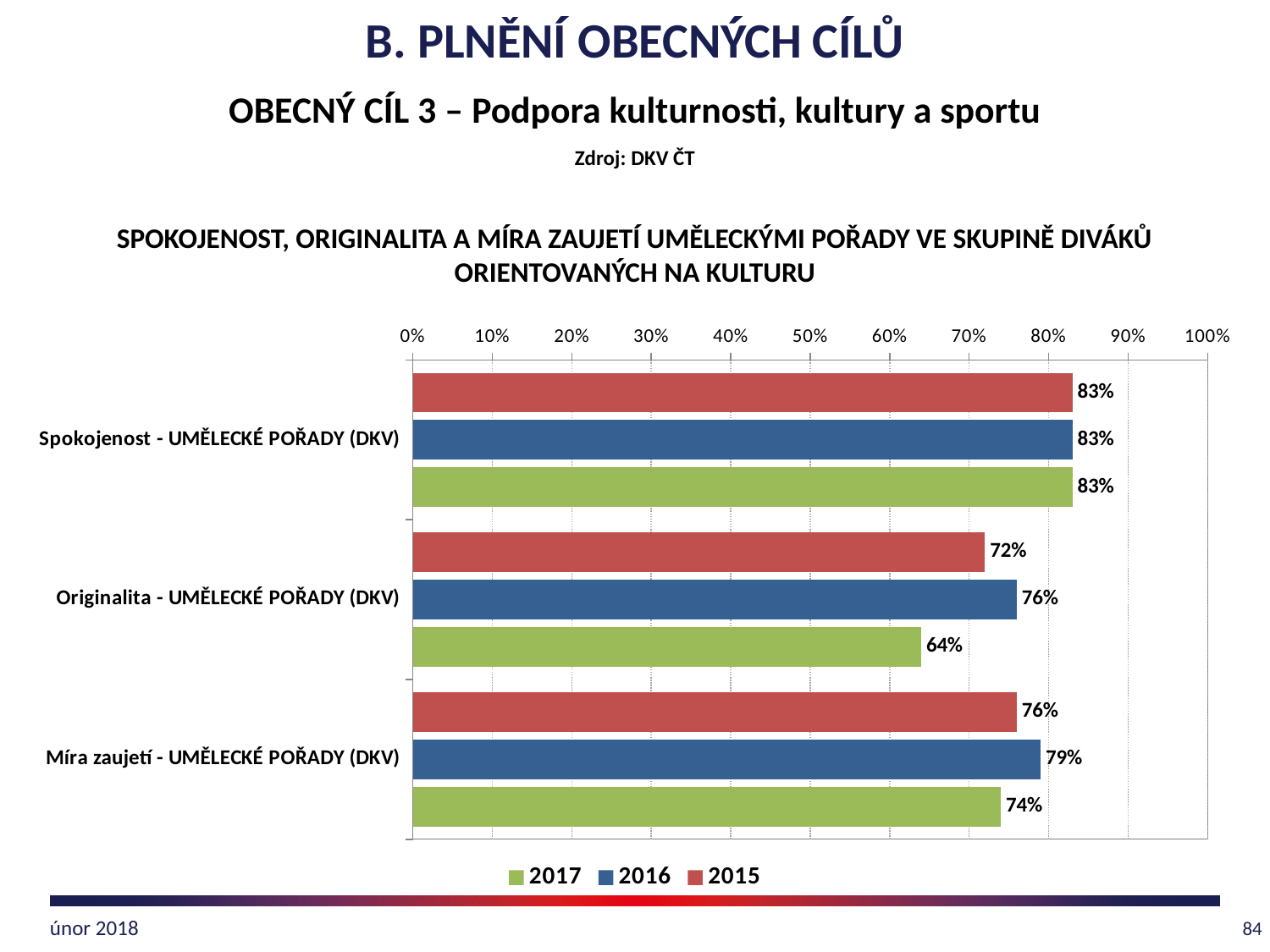
What is the difference between the 2016 and 2017 values for Originalita - UMĚLECKÉ POŘADY (DKV)? 12% Which year has the lowest value for Míra zaujetí - UMĚLECKÉ POŘADY (DKV)? 2017 What is the 2016 value for Míra zaujetí - UMĚLECKÉ POŘADY (DKV)? 79% Is the 2017 value for Originalita - UMĚLECKÉ POŘADY (DKV) greater or less than 70%? less What is the 2015 value for Originalita - UMĚLECKÉ POŘADY (DKV)? 72% What is the 2017 value for Originalita - UMĚLECKÉ POŘADY (DKV)? 64% What is the 2017 value for Spokojenost - UMĚLECKÉ POŘADY (DKV)? 83% Which year has the highest value for Originalita - UMĚLECKÉ POŘADY (DKV)? 2016 How many categories are shown on the chart? 3 What kind of chart is shown on the slide? bar chart Which is larger for Míra zaujetí - UMĚLECKÉ POŘADY (DKV): the 2015 value or the 2017 value? 2015 How many series does the legend list? 3